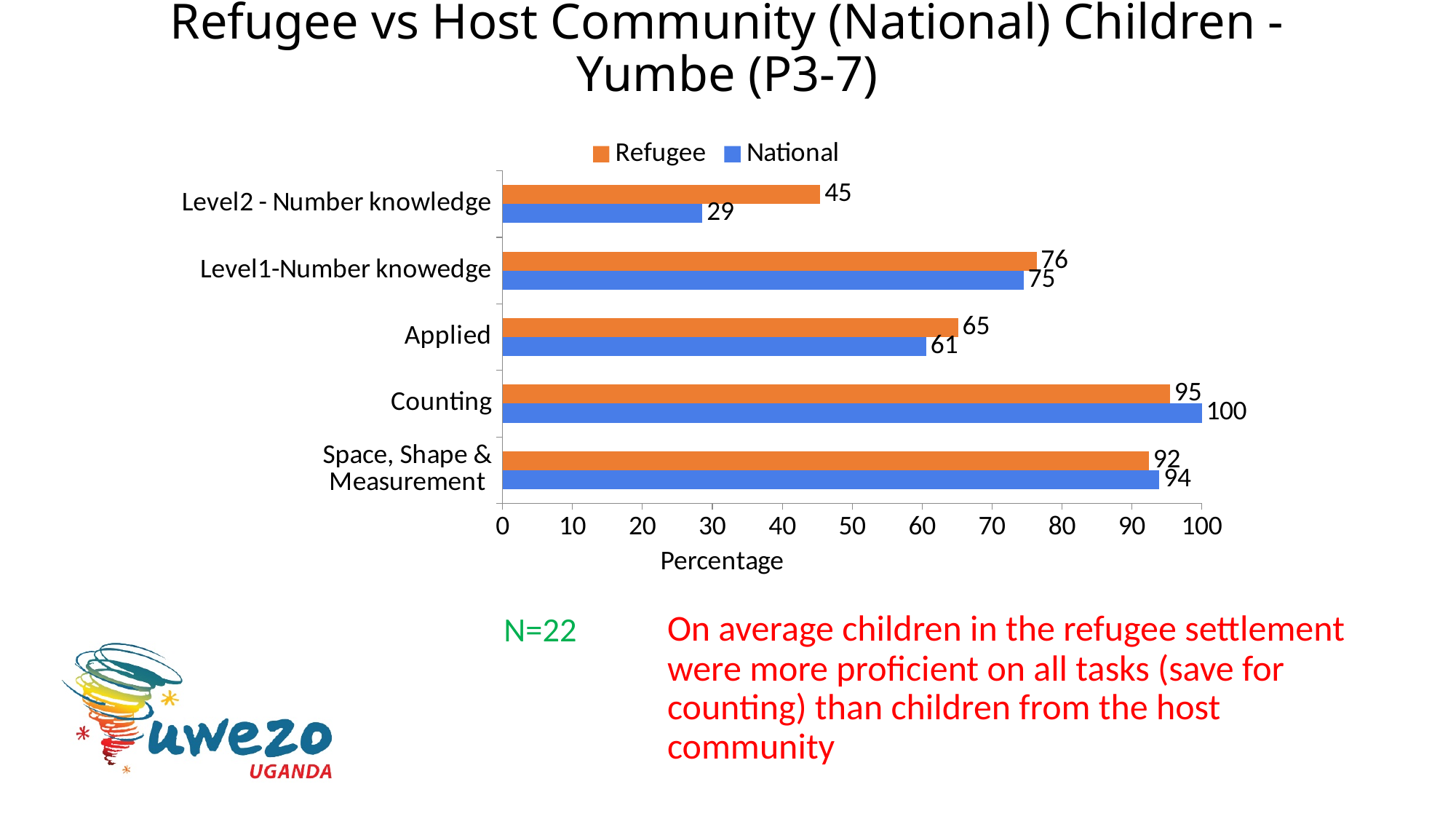
How many series does the legend list? 2 What is the difference between the Refugee and National values for Level2 - Number knowledge? 16 For Counting, which series has the larger value, Refugee or National? National Is the Refugee value for Applied greater or less than 60? greater Which category has the highest Refugee value? Counting What is the label of the horizontal axis? Percentage What kind of chart is shown on the slide? bar chart Which category has the lowest National value? Level2 - Number knowledge What is the National value for Counting? 100 What is the National value for Applied? 61 How many categories are shown on the chart? 5 What is the Refugee value for Level2 - Number knowledge? 45